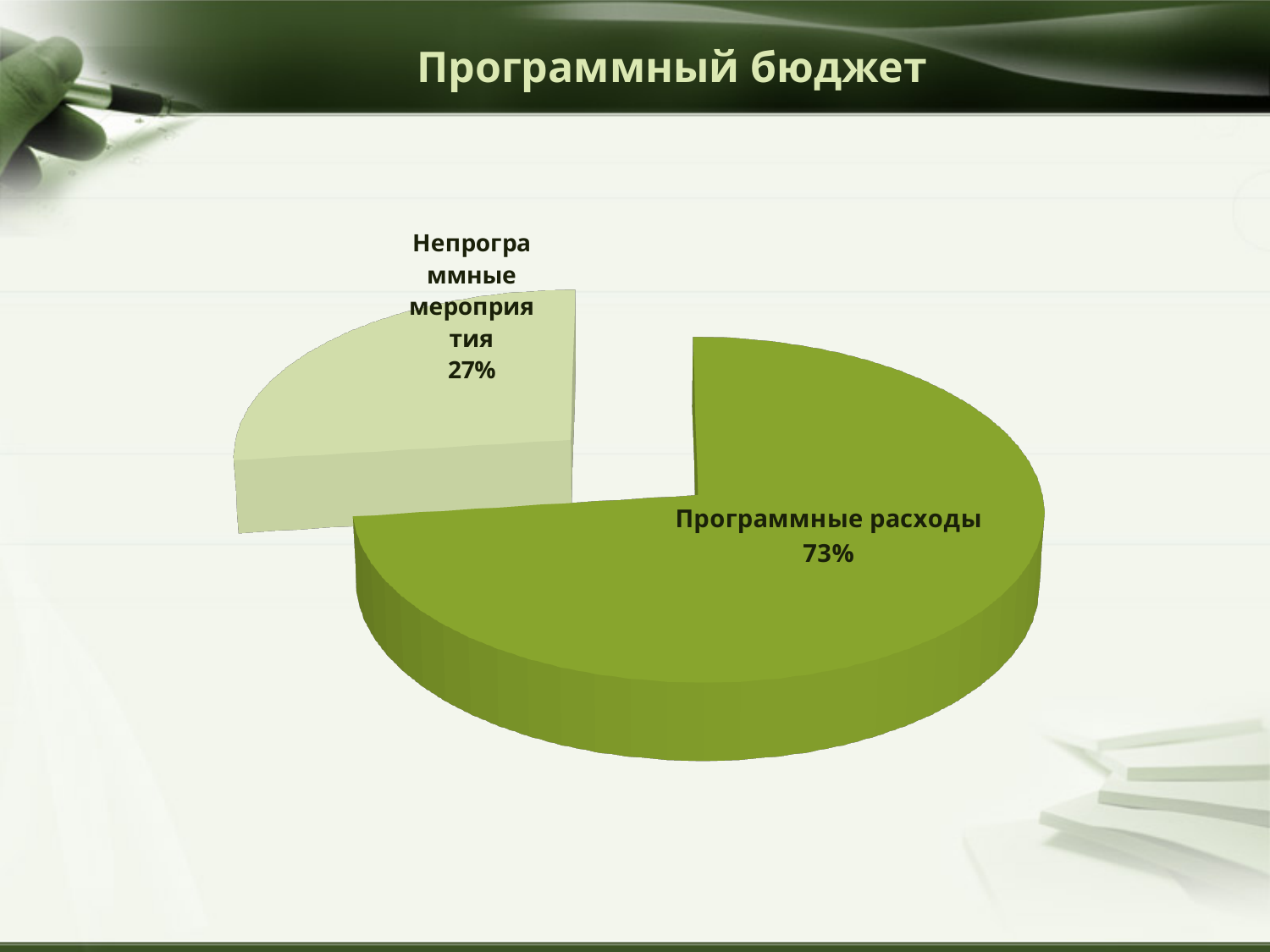
What share of the pie is labelled "Непрограммные мероприятия"? 27% What is the title of the slide containing the chart? Программный бюджет Which slice of the pie is the smallest? Непрограммные мероприятия Do the two slices of the pie add up to 100%? Yes What is the difference in percentage points between the "Программные расходы" slice and the "Непрограммные мероприятия" slice? 46 percentage points Which slice of the pie is the largest? Программные расходы Which slice is pulled out (exploded) from the rest of the pie? Непрограммные мероприятия How many slices does the pie chart have? 2 Is the share for "Программные расходы" greater or less than 50%? greater What kind of chart is shown on the slide? Pie chart What share of the pie is labelled "Программные расходы"? 73% Which is larger: the share for "Программные расходы" or the share for "Непрограммные мероприятия"? Программные расходы